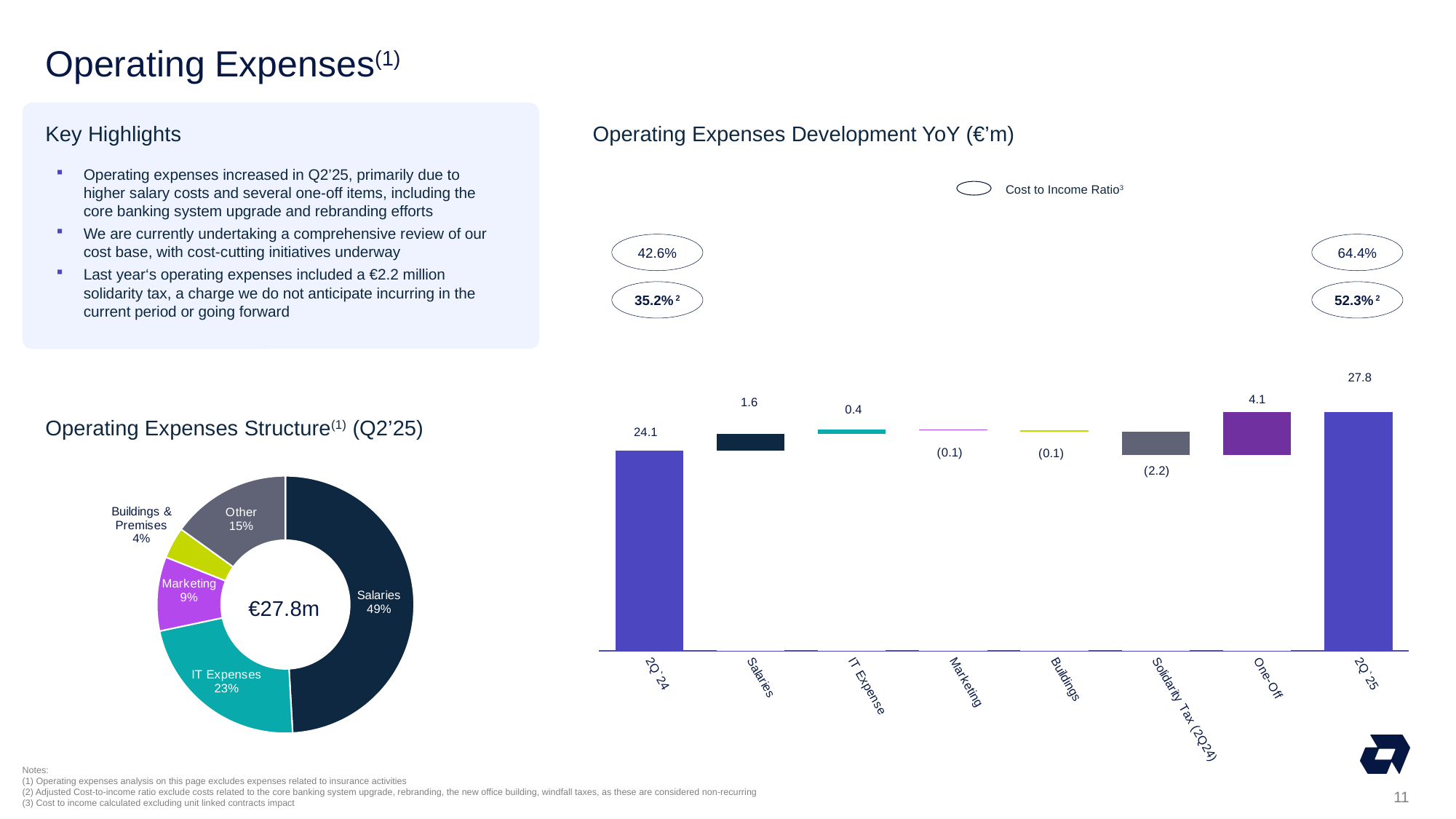
In the Operating Expenses Development YoY chart, how many bars are plotted along the x axis? 8 In the Operating Expenses Development YoY chart, which is larger, the Salaries bar or the IT Expense bar? Salaries In the Operating Expenses Structure (Q2'25) chart, what share do Salaries represent? 49% In the Operating Expenses Development YoY chart, what is the difference between the 2Q'25 and 2Q'24 values? 3.7 In the Operating Expenses Structure (Q2'25) chart, which category has the smallest share? Buildings & Premises In the Operating Expenses Structure (Q2'25) chart, what total amount is shown in the centre of the donut? €27.8m In the Operating Expenses Development YoY chart, what is the value shown for One-Off? 4.1 In the Operating Expenses Development YoY chart, what is the value for 2Q'25? 27.8 What kind of chart is the Operating Expenses Structure (Q2'25) chart? Donut (pie) chart In the Operating Expenses Development YoY chart, what is the Cost to Income Ratio shown for 2Q'25? 64.4% In the Operating Expenses Development YoY chart, what is the value for 2Q'24? 24.1 In the Operating Expenses Development YoY chart, what is the value shown for Solidarity Tax (2Q24)? (2.2)